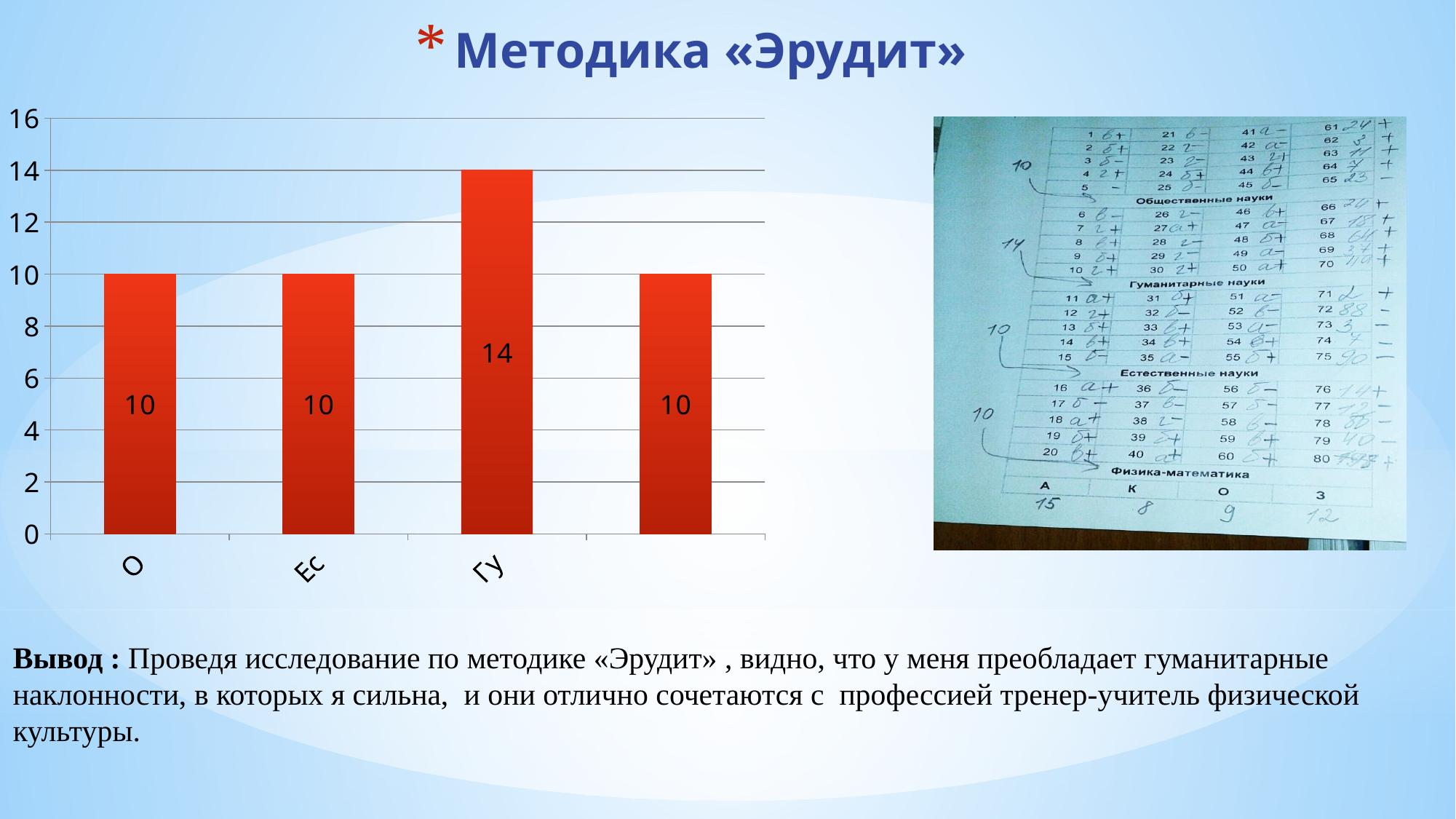
Is the value for О greater or less than 12? less What kind of chart is shown on the slide? bar chart Is the value for ГУ greater or less than 12? greater Which is larger, the value for ГУ or the value for Ес? ГУ How many bars are plotted in the chart? 4 What is the difference between the values for ГУ and Ес? 4 What is the difference between the values for ГУ and О? 4 What is the value for ГУ in the bar chart? 14 What colour are the bars in the chart? red What is the value for О in the bar chart? 10 What is the value for Ес in the bar chart? 10 Which category has the highest value in the bar chart? ГУ